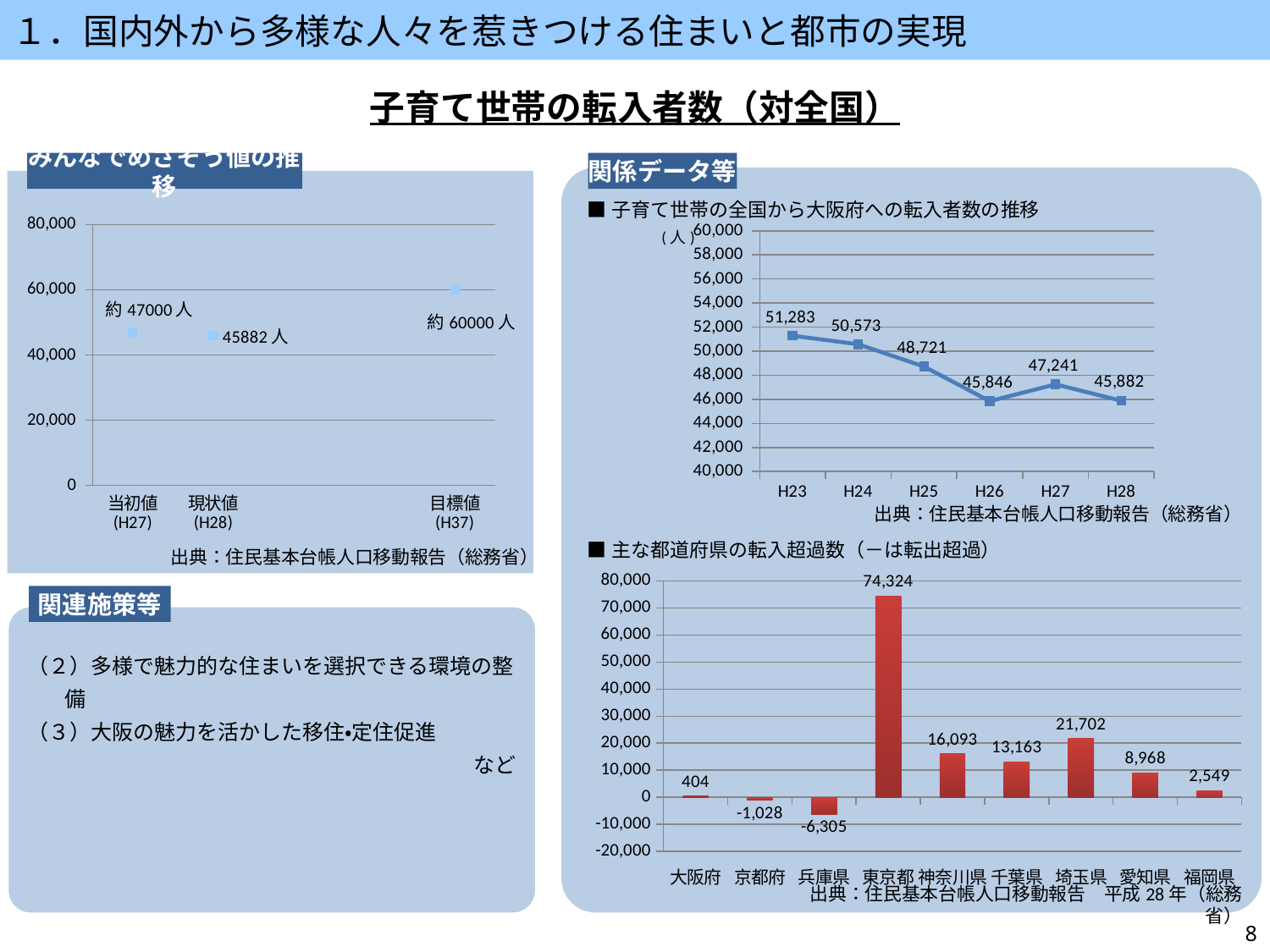
In the bar chart titled 主な都道府県の転入超過数, how many prefectures are shown on the x axis? 9 In the chart on the left titled みんなでめざそう値の推移, what is the value labelled for 現状値 (H28)? 45882人 In the line chart titled 子育て世帯の全国から大阪府への転入者数の推移, what is the value for H23? 51,283 In the bar chart titled 主な都道府県の転入超過数, which is larger, the value for 埼玉県 or the value for 神奈川県? 埼玉県 In the line chart titled 子育て世帯の全国から大阪府への転入者数の推移, how many data points are plotted? 6 In the line chart titled 子育て世帯の全国から大阪府への転入者数の推移, which year has the lowest value? H26 In the line chart titled 子育て世帯の全国から大阪府への転入者数の推移, what is the difference between the H23 value and the H25 value? 2,562 In the bar chart titled 主な都道府県の転入超過数, what is the value for 兵庫県? -6,305 In the line chart titled 子育て世帯の全国から大阪府への転入者数の推移, what is the value for H28? 45,882 In the bar chart titled 主な都道府県の転入超過数, which prefecture has the highest value? 東京都 What kind of chart is the chart titled 主な都道府県の転入超過数? bar chart In the bar chart titled 主な都道府県の転入超過数, what is the value for 東京都? 74,324